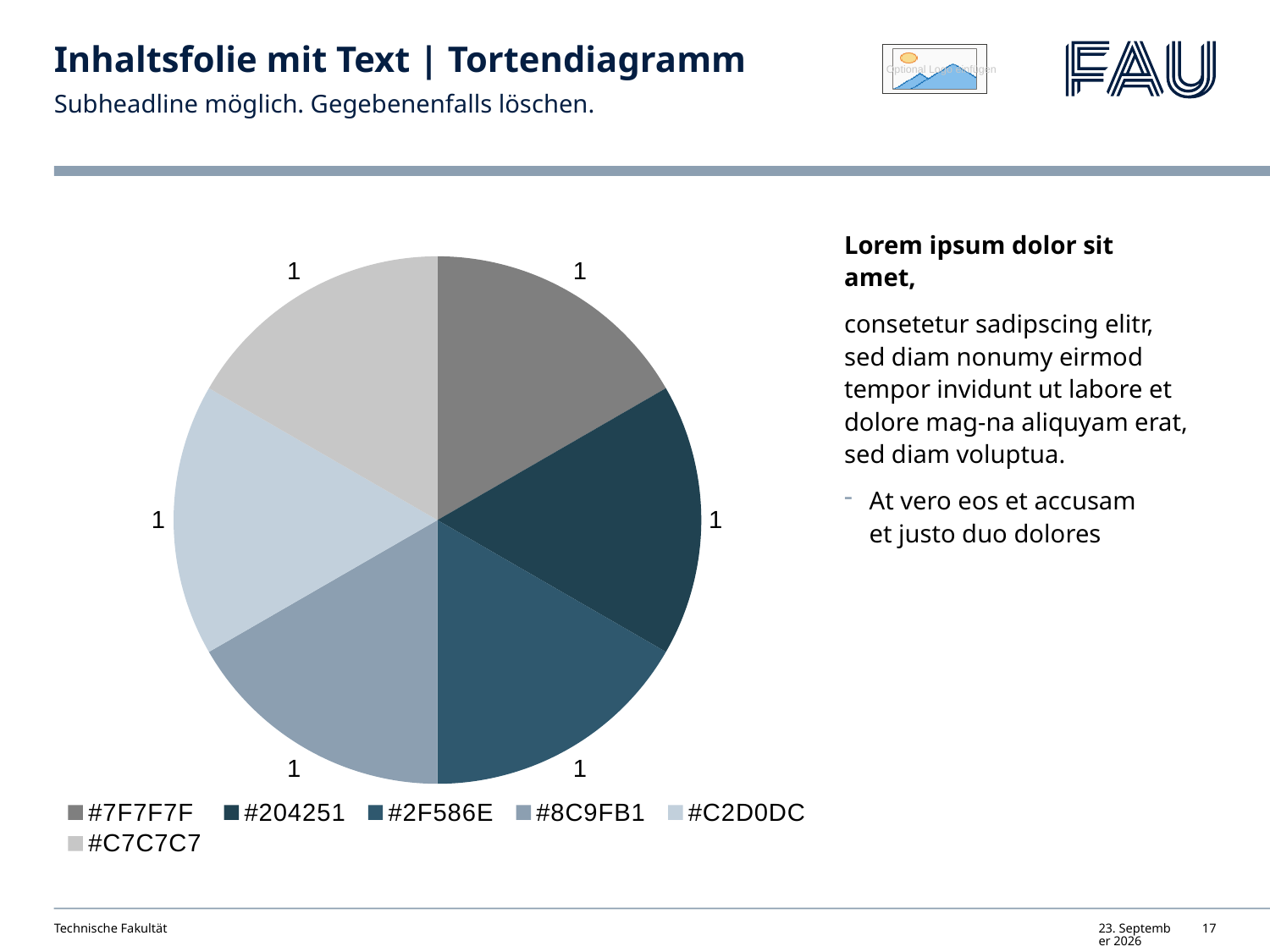
What is the first entry listed in the pie chart's legend? #7F7F7F What kind of chart is shown on the slide? Pie chart What is the value shown for the #C7C7C7 slice of the pie chart? 1 Which is larger, the value of the #C2D0DC slice or the #7F7F7F slice? They are equal What is the value shown for the #7F7F7F slice of the pie chart? 1 What is the difference between the values of the #2F586E and #8C9FB1 slices? 0 What is the last entry listed in the pie chart's legend? #C7C7C7 What fraction of the pie does the #8C9FB1 slice represent? 1/6 How many entries does the legend of the pie chart list? 6 What is the value shown for the #204251 slice of the pie chart? 1 What is the total of all the slice values in the pie chart? 6 How many slices does the pie chart have? 6